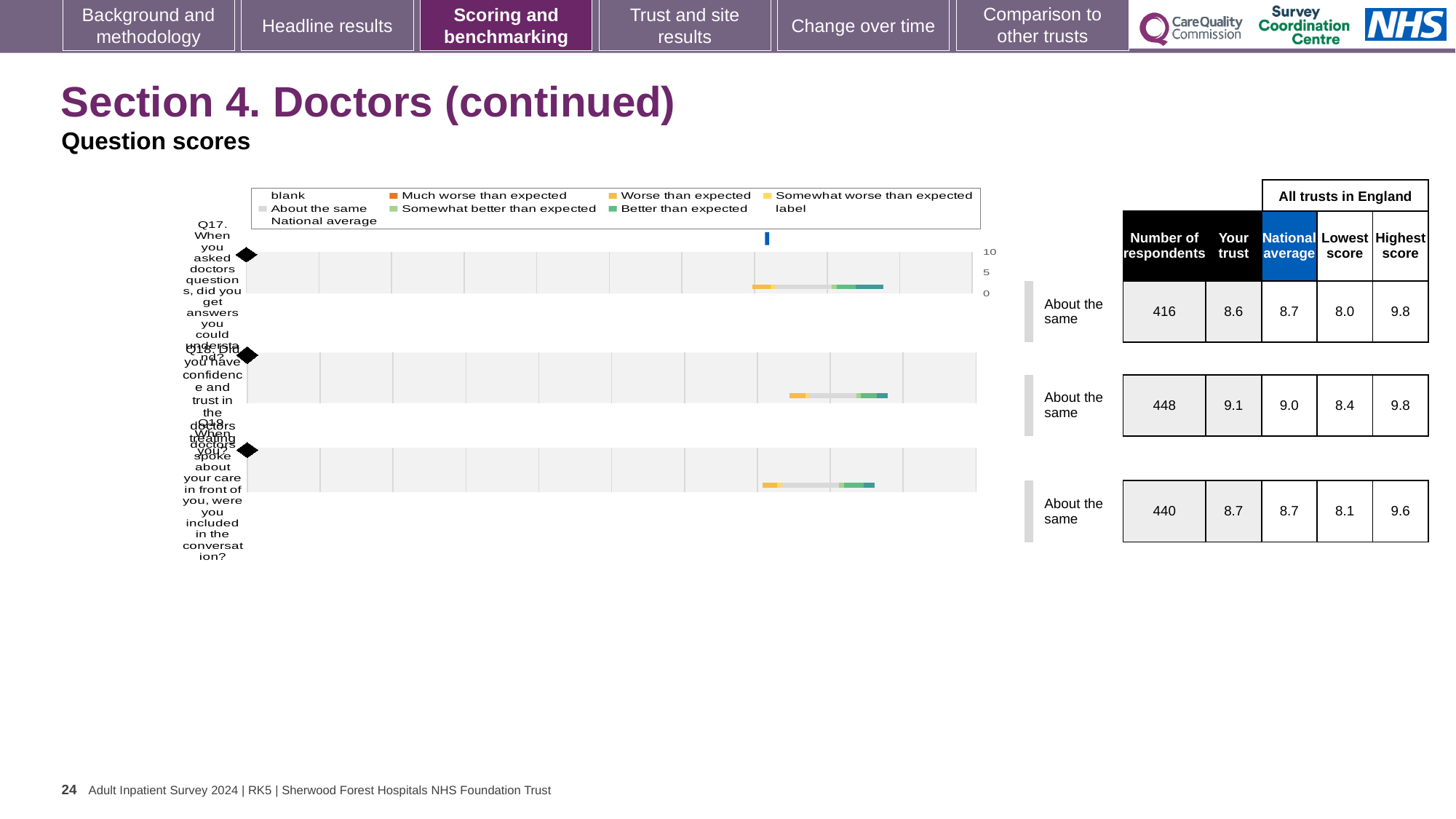
According to the table, what is the 'Your trust' score for Q17? 8.6 According to the table, what is the 'Your trust' score for Q18? 9.1 According to the table, how many respondents answered Q18? 448 Which question has the highest 'Your trust' score in the table? Q18 Is the 'Your trust' score for Q18 larger or smaller than the national average for Q18? larger What kind of chart is shown on the slide? bar chart Which question has the lowest 'Your trust' score in the table? Q17 How many questions (categories) are plotted in the chart? 3 Which question is plotted in the top row of the chart? Q17 What is the difference between the highest score and the lowest score for Q19 in the table? 1.5 What colour does the legend use for 'Much worse than expected'? orange According to the table, what is the national average for Q19? 8.7